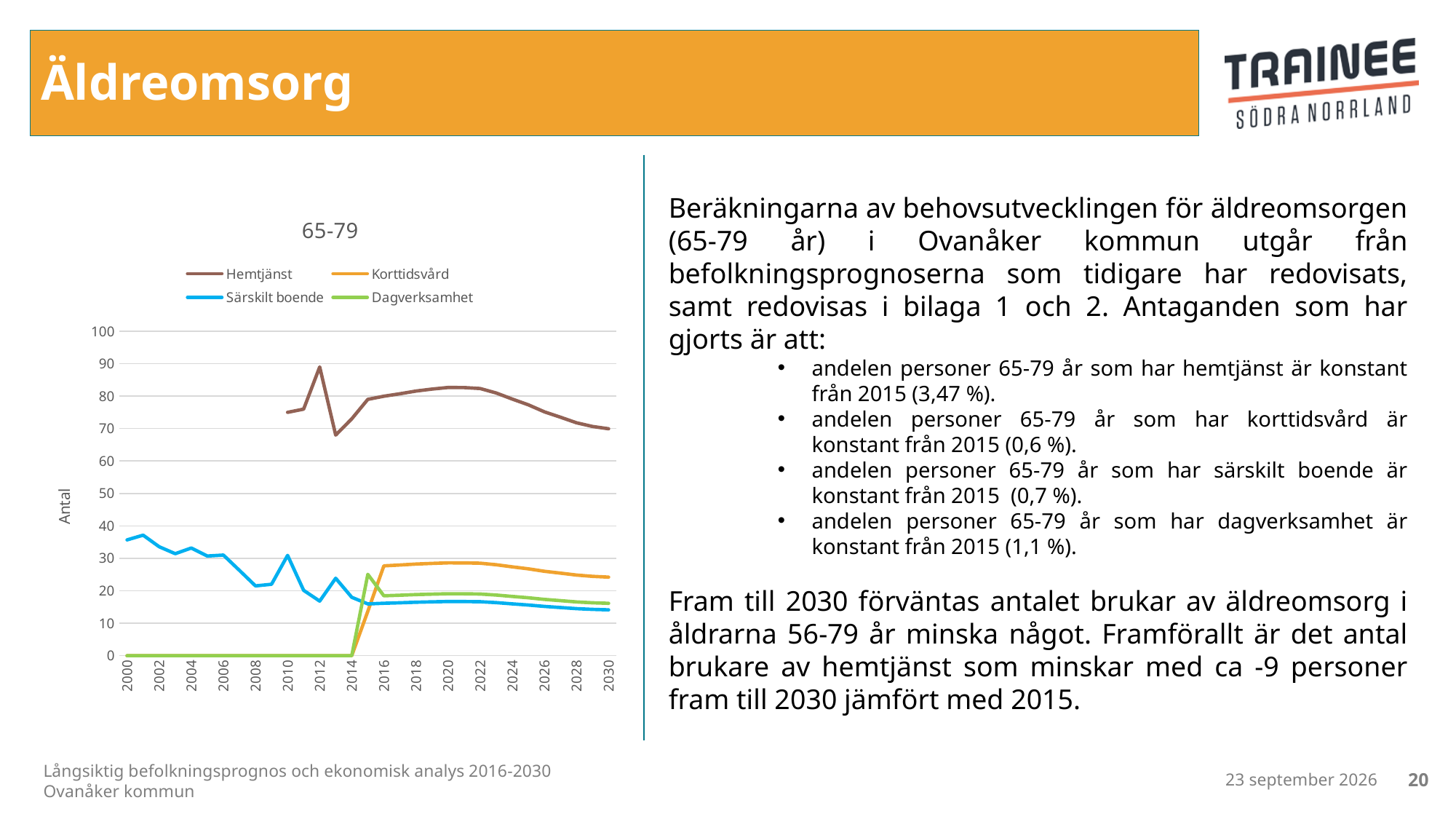
Is the value for Hemtjänst in 2012 greater or less than 80? greater In 2030, which is larger: the value for Korttidsvård or the value for Särskilt boende? Korttidsvård What is the title of the chart? 65-79 Is the value for Särskilt boende in 2000 greater or less than 30? greater What is the label on the chart's vertical axis? Antal Is the value for Korttidsvård in 2016 greater or less than 20? greater What kind of chart is shown on the slide? line chart How many series does the chart's legend list? 4 Which series has the highest value in 2020? Hemtjänst Does the Hemtjänst line rise or fall between 2022 and 2030? fall